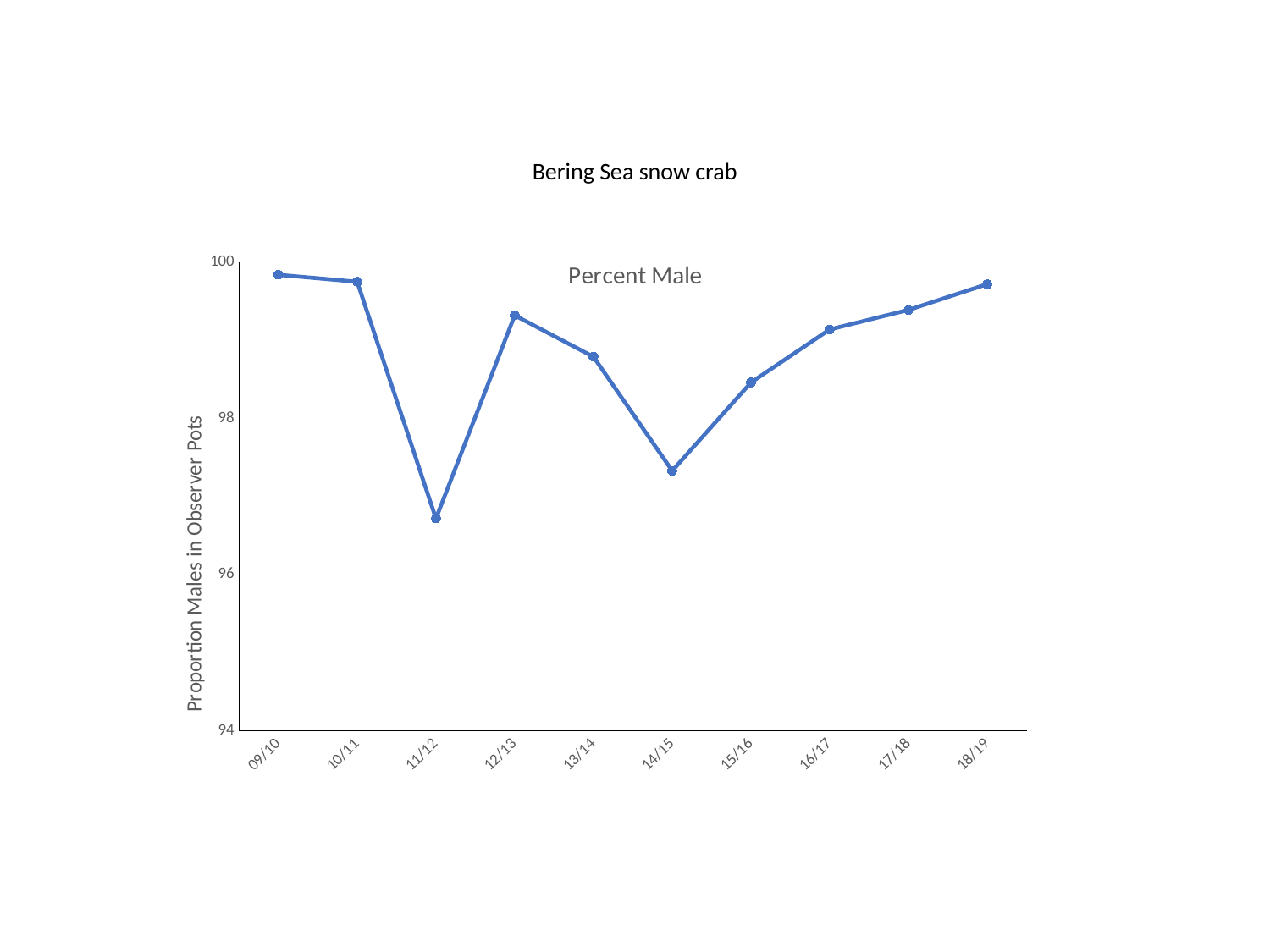
Is the value for 13/14 greater or less than 98? greater Is the value for 09/10 greater or less than 98? greater Is the value for 11/12 greater or less than 96? greater Which is higher, the value for 14/15 or the value for 16/17? 16/17 Which is higher, the value for 12/13 or the value for 13/14? 12/13 What is the title of the chart? Percent Male What kind of chart is shown on the slide? line chart Do the values rise or fall from 14/15 to 18/19? rise Which season has the lowest percent male? 11/12 How many seasons are plotted along the x axis? 10